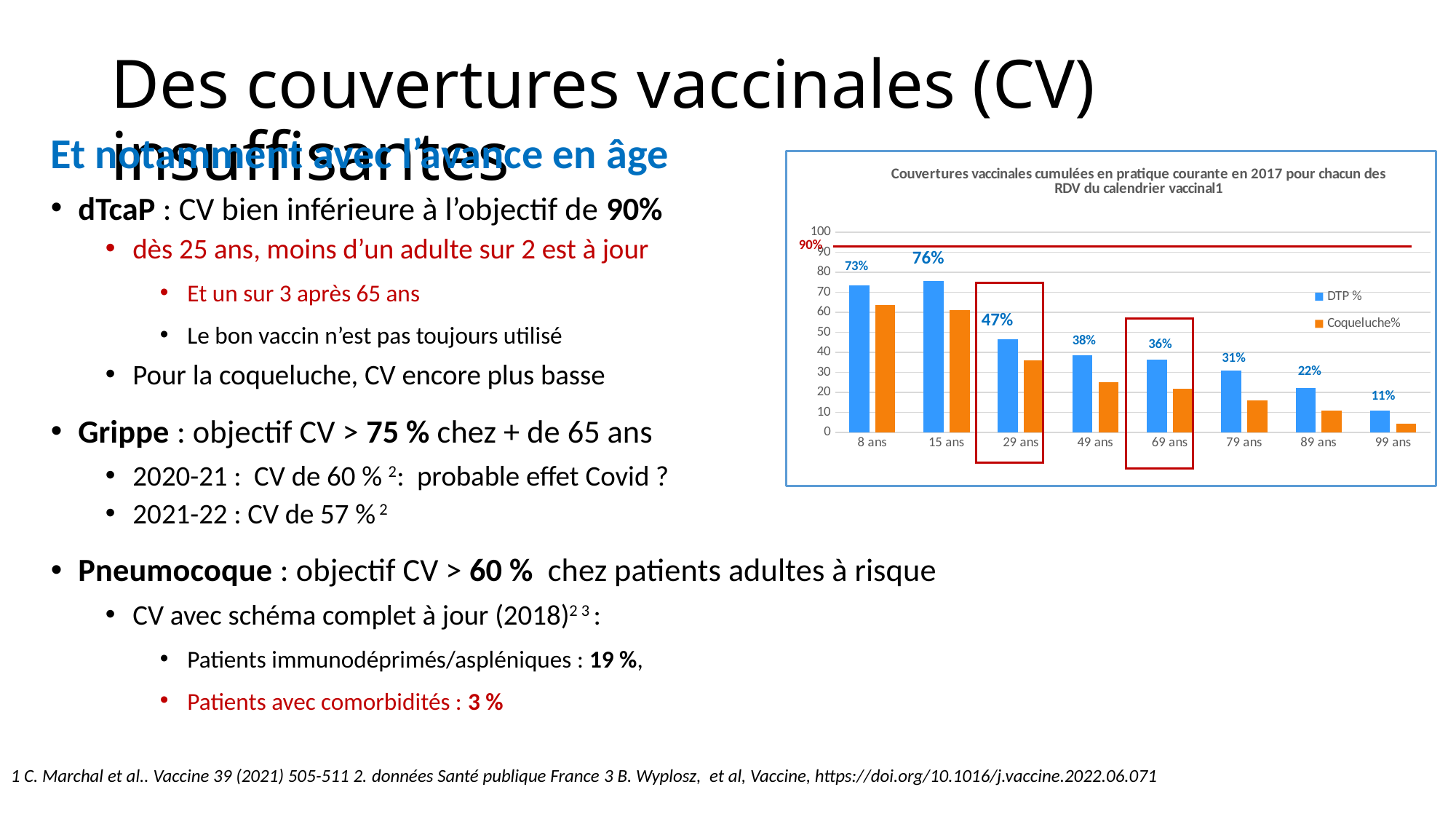
What kind of chart is shown on the slide? Bar chart Which age group has the highest DTP % value? 15 ans What is the DTP % value for 8 ans? 73% What is the DTP % value for 89 ans? 22% Is the Coqueluche% value for 99 ans greater or less than 10? less How many series does the chart legend list? 2 What is the difference between the DTP % values for 15 ans and 8 ans? 3 percentage points How many age groups are shown on the x axis of the chart? 8 Which age group has the lowest DTP % value? 99 ans Is the Coqueluche% value for 29 ans greater or less than 40? less What is the DTP % value for 29 ans? 47% Which has the larger DTP % value, 49 ans or 69 ans? 49 ans